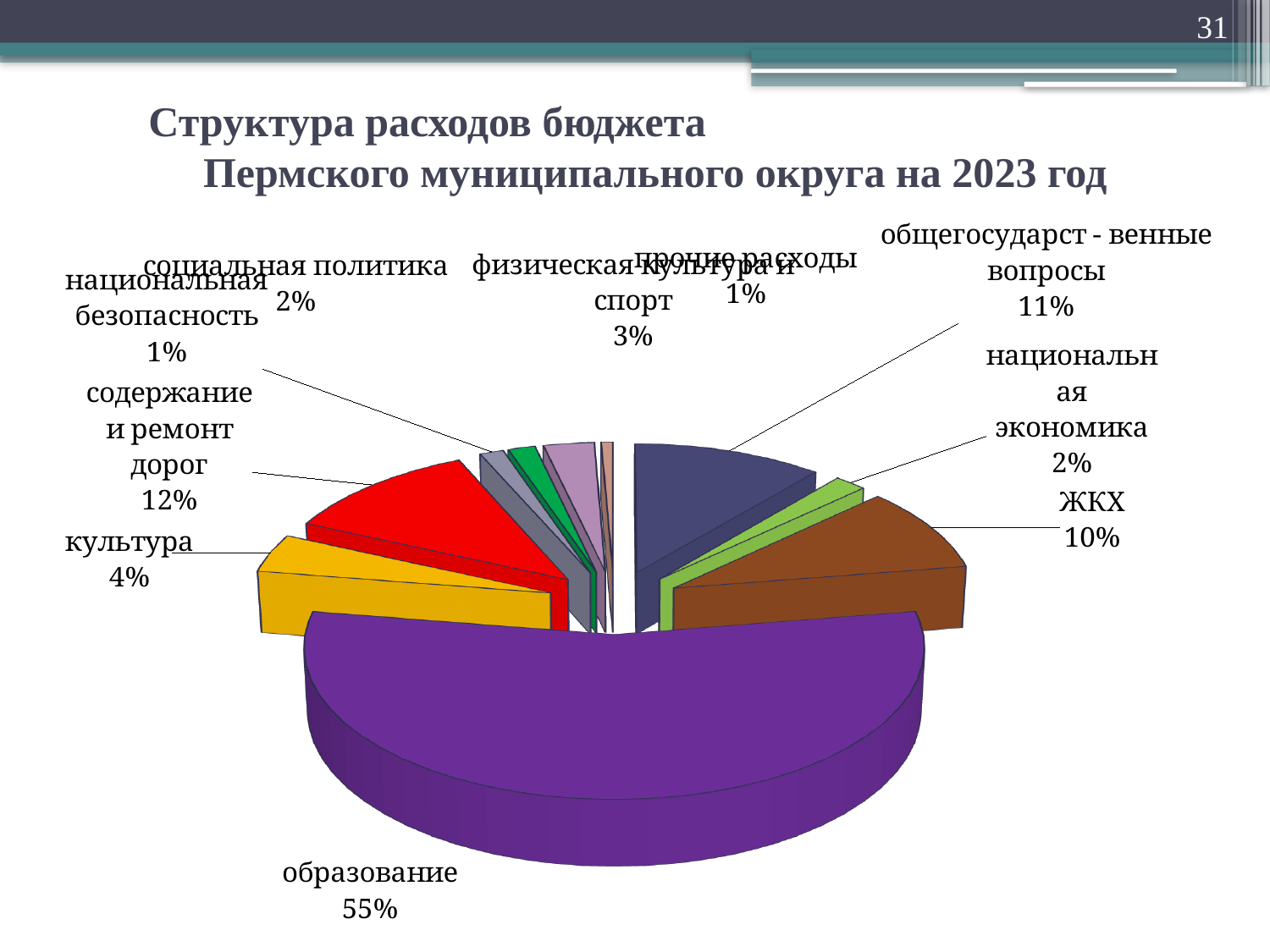
What kind of chart is shown on the slide? pie chart What share of the budget expenditure goes to содержание и ремонт дорог? 12% What is the difference in percentage points between the share for образование and the share for общегосударственные вопросы? 44 What share of the budget expenditure goes to общегосударственные вопросы? 11% What is the share for физическая культура и спорт? 3% Which category has the largest share of the budget expenditure? образование How many categories are shown in the pie chart? 10 What share of the budget expenditure goes to культура? 4% Which is larger, the share for содержание и ремонт дорог or the share for ЖКХ? содержание и ремонт дорог What share of the budget expenditure goes to образование? 55% What share of the budget expenditure goes to ЖКХ? 10% What is the title of the chart? Структура расходов бюджета Пермского муниципального округа на 2023 год